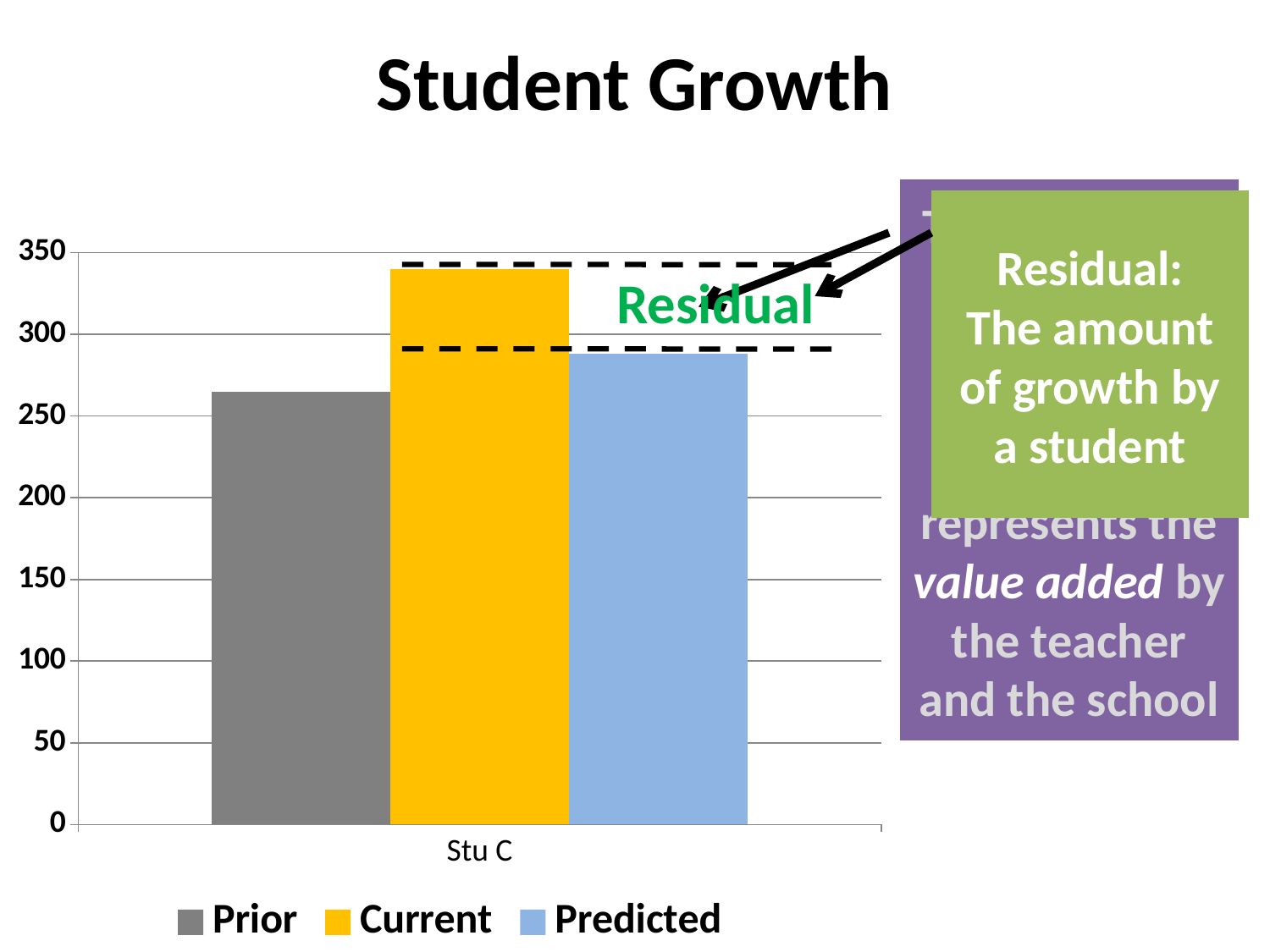
Which is larger for Stu C, the Predicted bar or the Prior bar? Predicted Is the Predicted bar for Stu C greater or less than 300? less Which is larger for Stu C, the Current bar or the Predicted bar? Current Is the Prior bar for Stu C greater or less than 250? greater Is the Current bar for Stu C greater or less than 300? greater What kind of chart is shown on the slide? bar chart What is the title of the chart? Student Growth Which series has the highest bar for Stu C? Current Which series has the lowest bar for Stu C? Prior How many series does the legend list? 3 How many categories are shown on the x axis? 1 What is the name of the category on the x axis? Stu C